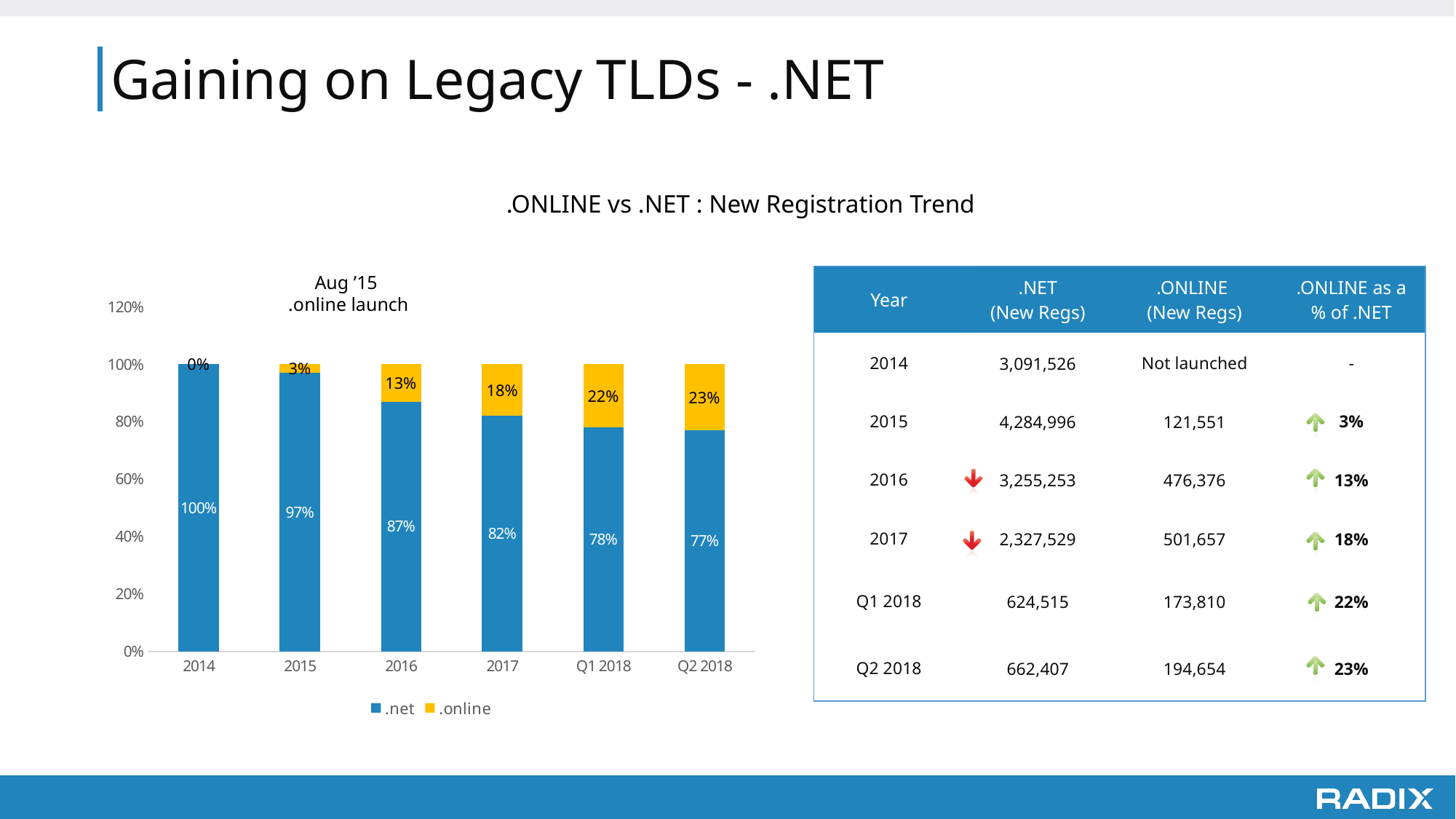
What is the .net share for 2016 in the stacked bar chart? 87% What is the .online share for 2015 in the stacked bar chart? 3% Which category has the lowest .net share in the stacked bar chart? Q2 2018 What is the title of the chart? .ONLINE vs .NET : New Registration Trend How many categories are shown on the x axis of the stacked bar chart? 6 How many series does the legend of the chart list? 2 What is the difference between the .net share in 2014 and in 2017? 18% What is the .online share for Q1 2018 in the stacked bar chart? 22% Is the .online share larger in 2016 or in 2017? 2017 Does the .net share rise or fall from 2014 to Q2 2018? Fall Which category has the highest .online share in the stacked bar chart? Q2 2018 What kind of chart is shown on the slide? Stacked bar chart